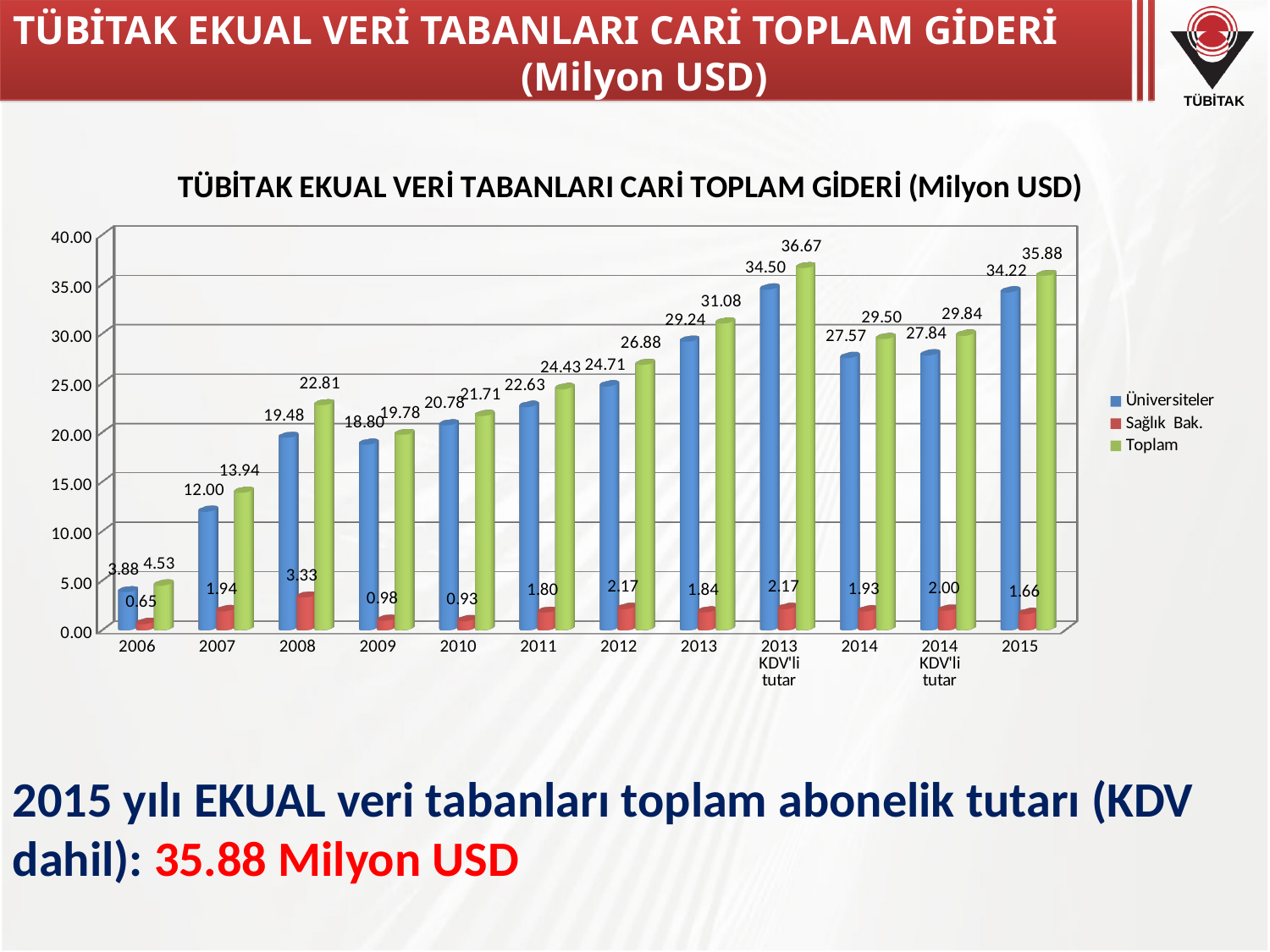
Which category has the highest Toplam value? 2013 KDV'li tutar What is the Üniversiteler value for 2008? 19.48 How many series does the legend list? 3 What kind of chart is shown on the slide? Bar chart Which category has the lowest Üniversiteler value? 2006 Which category has the highest Sağlık Bak. value? 2008 How many categories are shown on the x axis? 12 What is the Sağlık Bak. value for 2010? 0.93 What is the difference between the Toplam values for 2013 KDV'li tutar and 2015? 0.79 What is the Toplam value for 2015? 35.88 Which series is shown in green in the legend? Toplam Which is larger, the Üniversiteler value for 2009 or for 2010? 2010